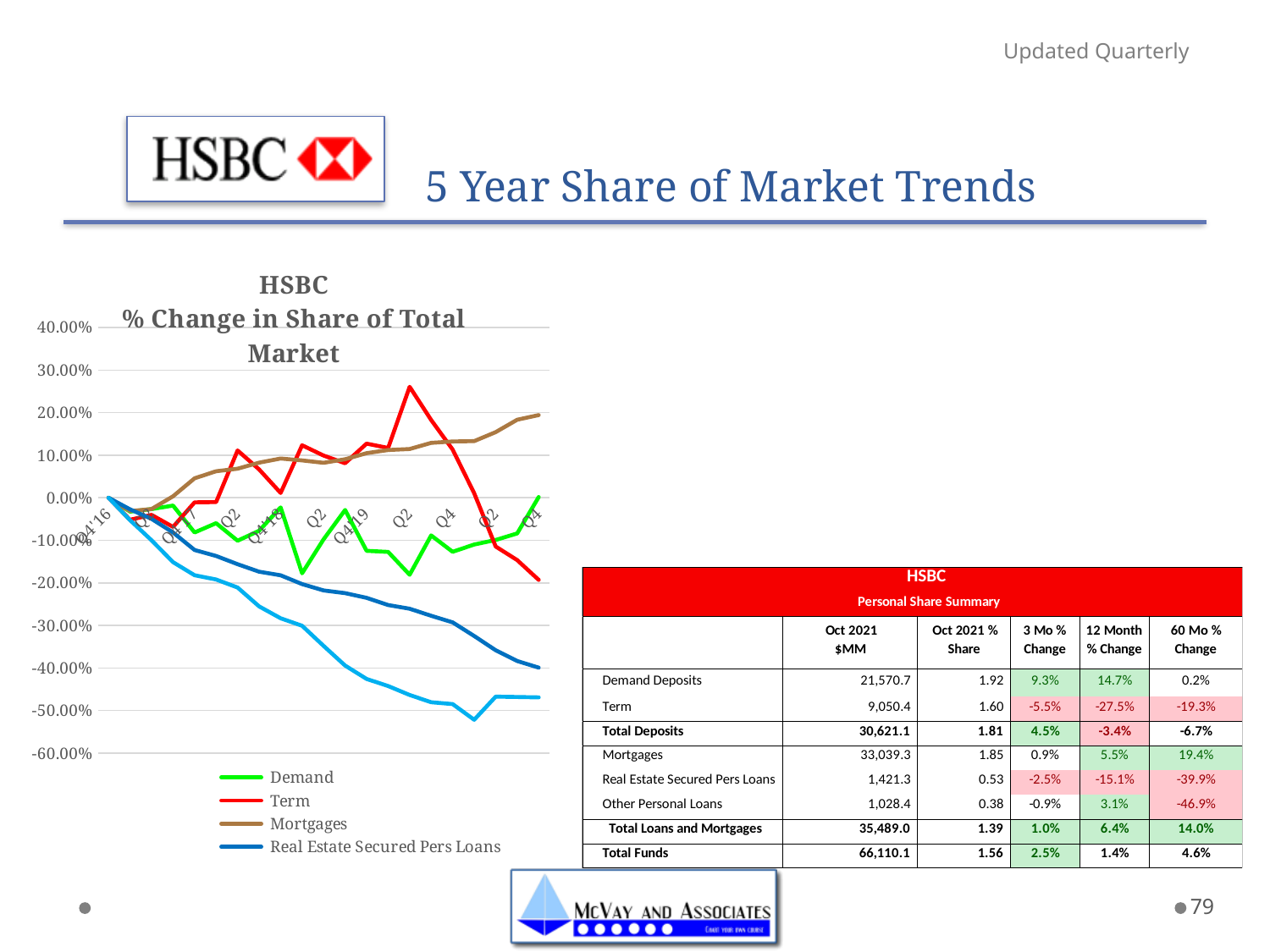
What is the title of the chart? HSBC % Change in Share of Total Market What colour is the Demand line in the chart? green What kind of chart is shown on the slide? line chart Is the final value of the Mortgages line greater or less than 10.00%? greater At the right end of the chart, which of Mortgages or Term has the larger value? Mortgages Does the Mortgages line generally rise or fall across the chart? rise Is the final value of the Real Estate Secured Pers Loans line greater or less than -30.00%? less How many series does the chart legend list? 4 At the right end of the chart, which series has the highest value? Mortgages Is the highest point of the Term line greater or less than 20.00%? greater Does the Real Estate Secured Pers Loans line generally rise or fall across the chart? fall